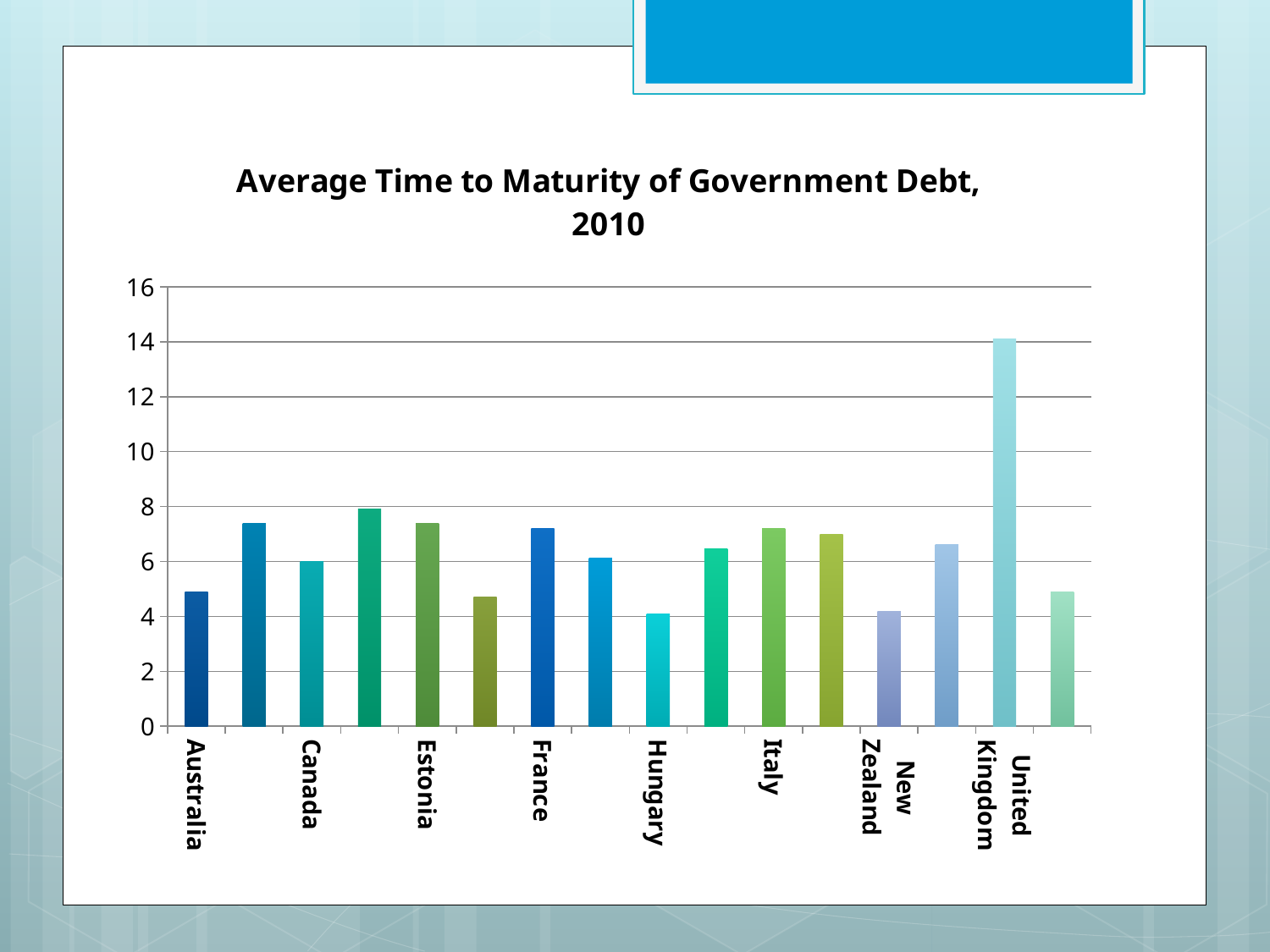
What is the title of the chart? Average Time to Maturity of Government Debt, 2010 Is the value for Estonia greater or less than 6? greater Which has a larger value, Australia or Canada? Canada Is the value for the United Kingdom greater or less than 12? greater How many bars are plotted in the chart? 16 Is the value for Hungary greater or less than 6? less Which has a larger value, Estonia or Hungary? Estonia What kind of chart is shown on the slide? bar chart Which country has the highest average time to maturity of government debt? United Kingdom